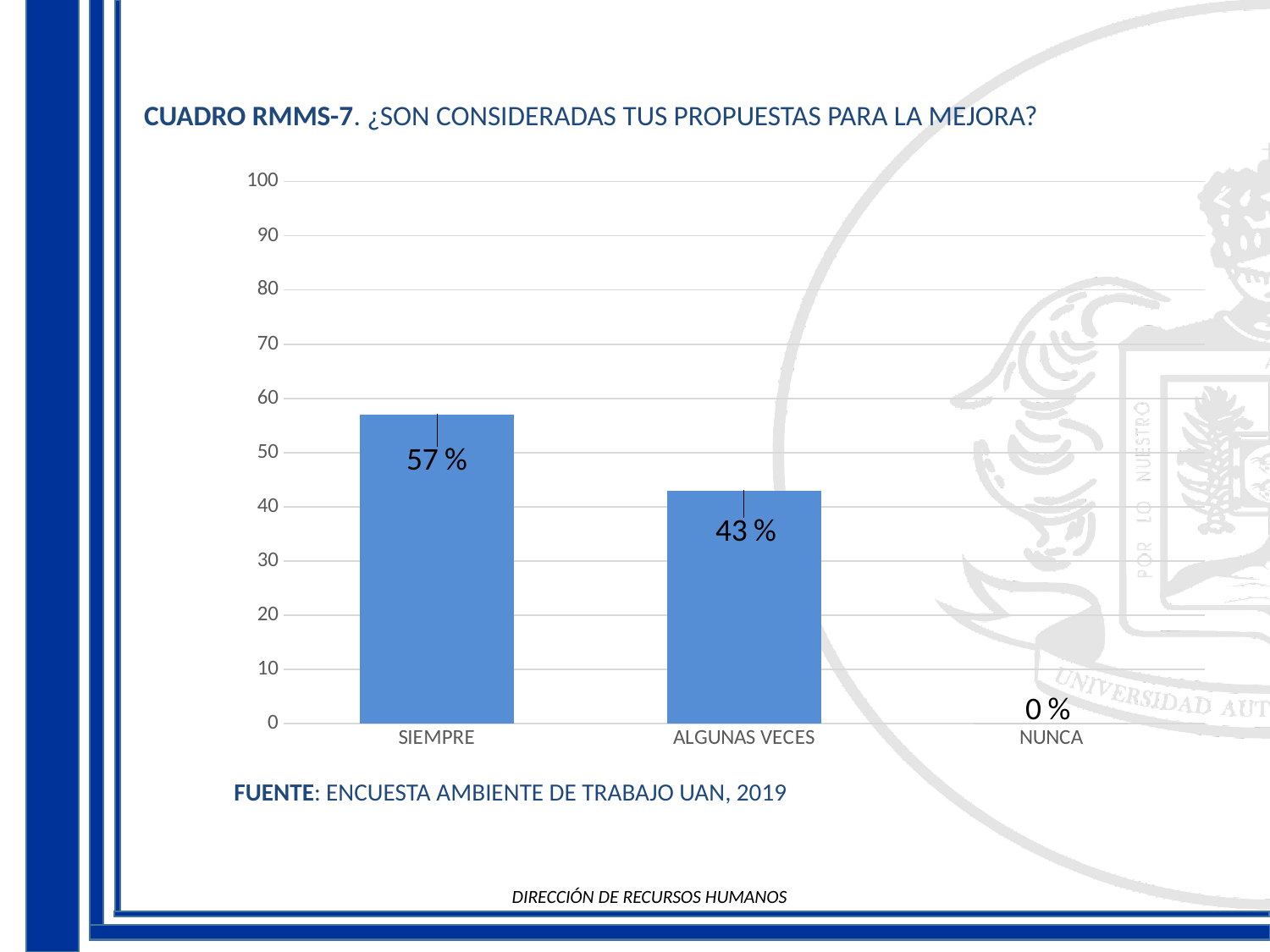
What is the source cited below the chart? ENCUESTA AMBIENTE DE TRABAJO UAN, 2019 What is the difference between the values for SIEMPRE and ALGUNAS VECES? 14 % Is the value for ALGUNAS VECES greater or less than 50? less How many categories are shown on the x axis? 3 Which category has the lowest value? NUNCA Do the values rise or fall from left to right along the x axis? fall Which is larger, the value for SIEMPRE or the value for ALGUNAS VECES? SIEMPRE Which category has the highest value? SIEMPRE What is the value for NUNCA? 0 % What is the value for SIEMPRE? 57 % What is the value for ALGUNAS VECES? 43 % What kind of chart is shown on the slide? bar chart